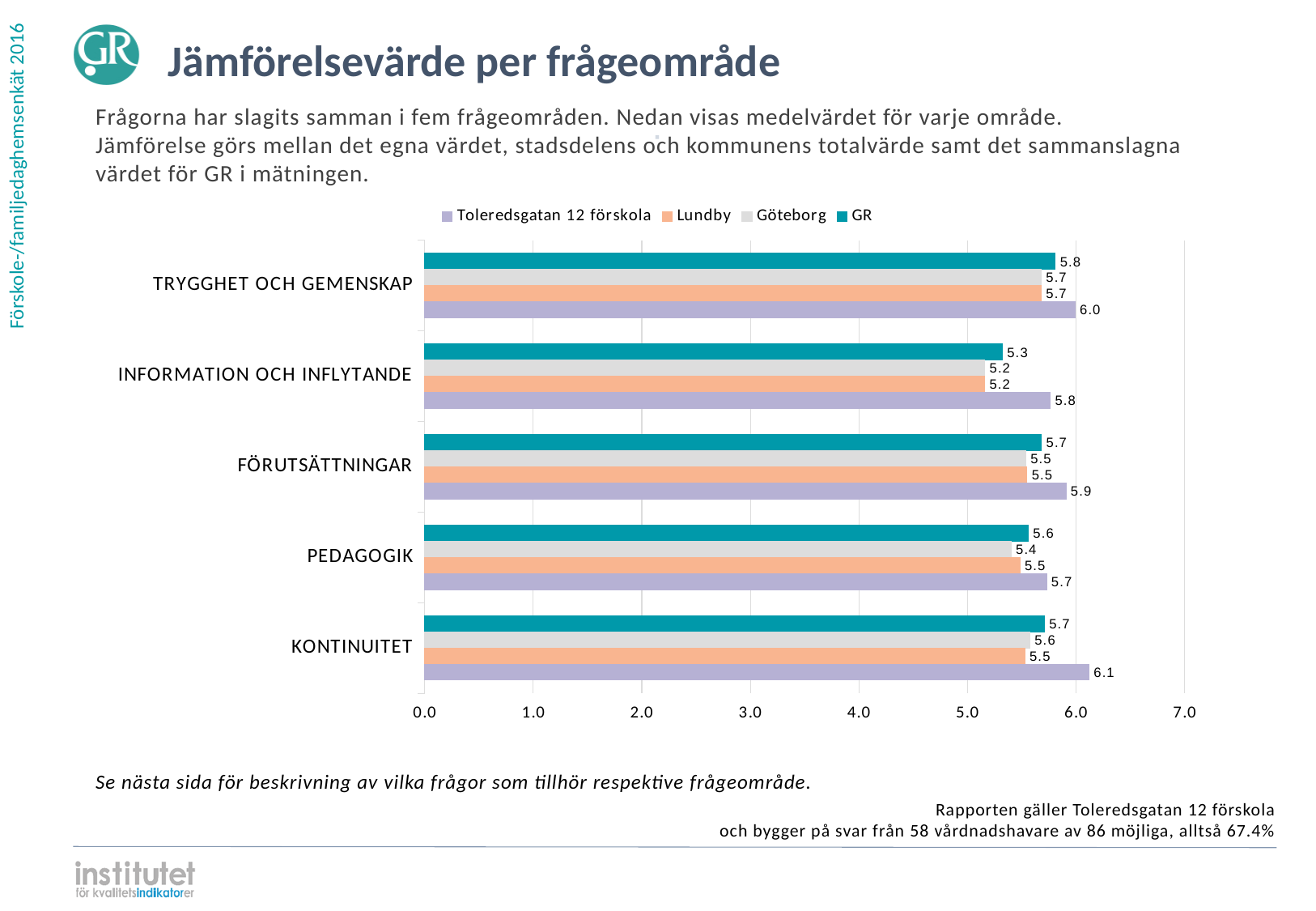
Which series is shown in teal in the legend? GR How many question areas (categories) are shown on the chart? 5 What is the value for Lundby in PEDAGOGIK? 5.5 How many series does the legend list? 4 In which question area does Toleredsgatan 12 förskola have its highest value? KONTINUITET Which is larger in TRYGGHET OCH GEMENSKAP: the value for Toleredsgatan 12 förskola or the value for GR? Toleredsgatan 12 förskola What is the value for GR in INFORMATION OCH INFLYTANDE? 5.3 In which question area does GR have its lowest value? INFORMATION OCH INFLYTANDE What kind of chart is shown on the slide? bar chart What is the value for Göteborg in FÖRUTSÄTTNINGAR? 5.5 What is the difference between Toleredsgatan 12 förskola and Lundby in INFORMATION OCH INFLYTANDE? 0.6 What is the value for Toleredsgatan 12 förskola in KONTINUITET? 6.1